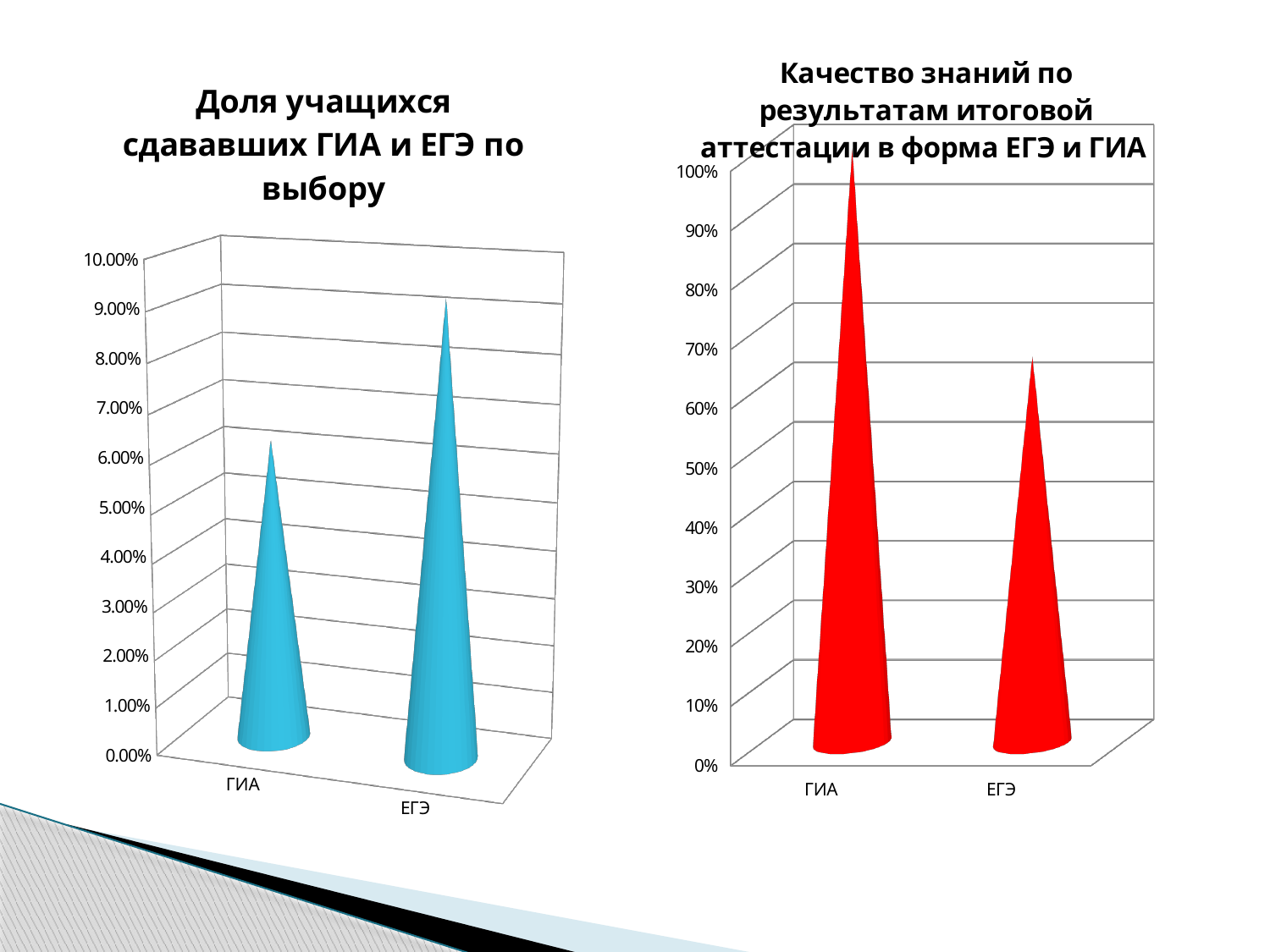
On the left chart (Доля учащихся сдававших ГИА и ЕГЭ по выбору), is the value for ЕГЭ greater or less than 7.00%? greater What colour are the bars on the left chart (Доля учащихся сдававших ГИА и ЕГЭ по выбору)? blue On the left chart (Доля учащихся сдававших ГИА и ЕГЭ по выбору), which category has the higher value? ЕГЭ On the right chart (Качество знаний по результатам итоговой аттестации), is the value for ГИА or for ЕГЭ larger? ГИА On the left chart (Доля учащихся сдававших ГИА и ЕГЭ по выбору), is the value for ГИА greater or less than 8.00%? less On the right chart (Качество знаний по результатам итоговой аттестации), which category has the higher value? ГИА What kind of chart is the right chart (Качество знаний по результатам итоговой аттестации)? bar chart On the right chart (Качество знаний по результатам итоговой аттестации), is the value for ГИА greater or less than 90%? greater On the left chart (Доля учащихся сдававших ГИА и ЕГЭ по выбору), which category has the lower value? ГИА On the left chart (Доля учащихся сдававших ГИА и ЕГЭ по выбору), how many categories are shown? 2